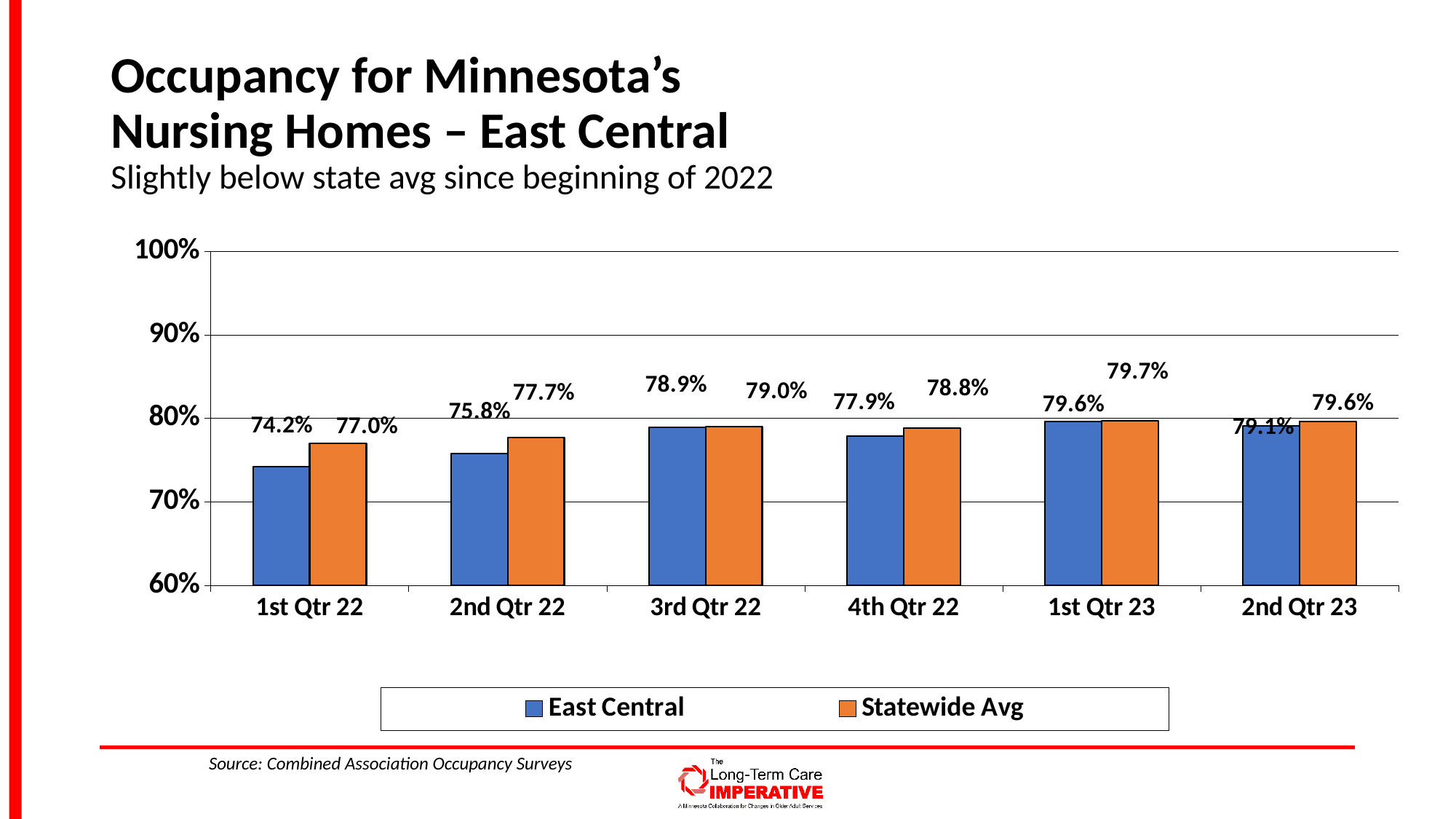
What is the East Central occupancy for 1st Qtr 22? 74.2% In which quarter is the East Central occupancy lowest? 1st Qtr 22 How many quarters are shown on the x axis? 6 What is the Statewide Avg occupancy for 4th Qtr 22? 78.8% What kind of chart is shown on the slide? Bar chart Is the East Central occupancy for 3rd Qtr 22 greater or less than 80%? less How many series does the legend list? 2 What is the East Central occupancy for 2nd Qtr 23? 79.1% Which colour represents the Statewide Avg series? Orange What is the difference between the Statewide Avg and East Central occupancy in 1st Qtr 22? 2.8% Which is larger in 2nd Qtr 22, the East Central occupancy or the Statewide Avg? Statewide Avg In which quarter is the East Central occupancy highest? 1st Qtr 23